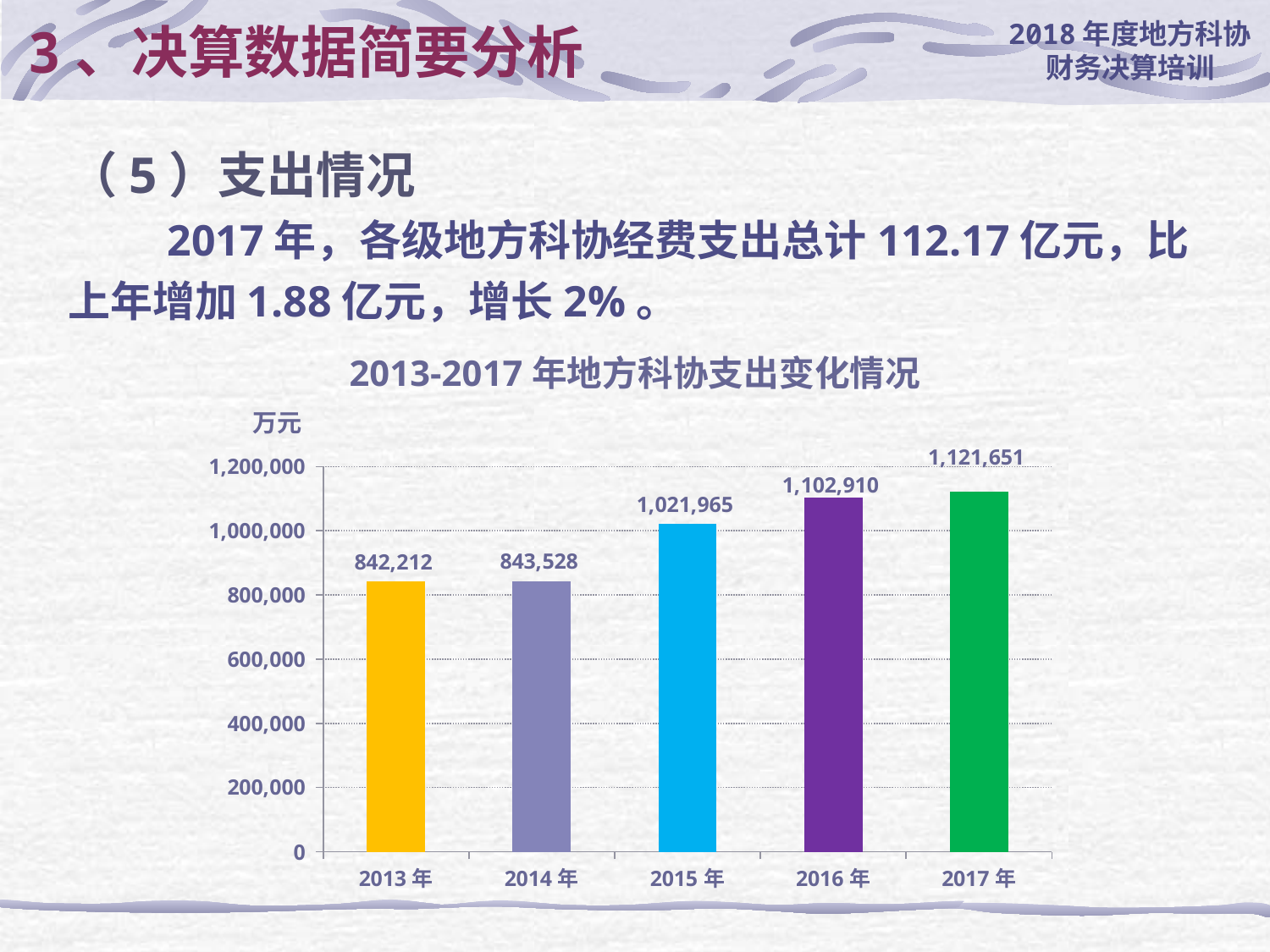
How many years are shown on the x axis of the chart? 5 What kind of chart is shown on the slide? bar chart Which is larger, the value for 2014年 or the value for 2013年? 2014年 What is the difference between the values for 2015年 and 2014年? 178,437 Which year has the highest value in the chart? 2017年 What is the difference between the values for 2017年 and 2016年? 18,741 What is the value for 2017年 in the chart? 1,121,651 Is the value for 2016年 greater or less than 1,000,000? greater Which year has the lowest value in the chart? 2013年 Do the values rise or fall from 2013年 to 2017年? rise What is the value for 2015年 in the chart? 1,021,965 What is the value for 2013年 in the chart? 842,212